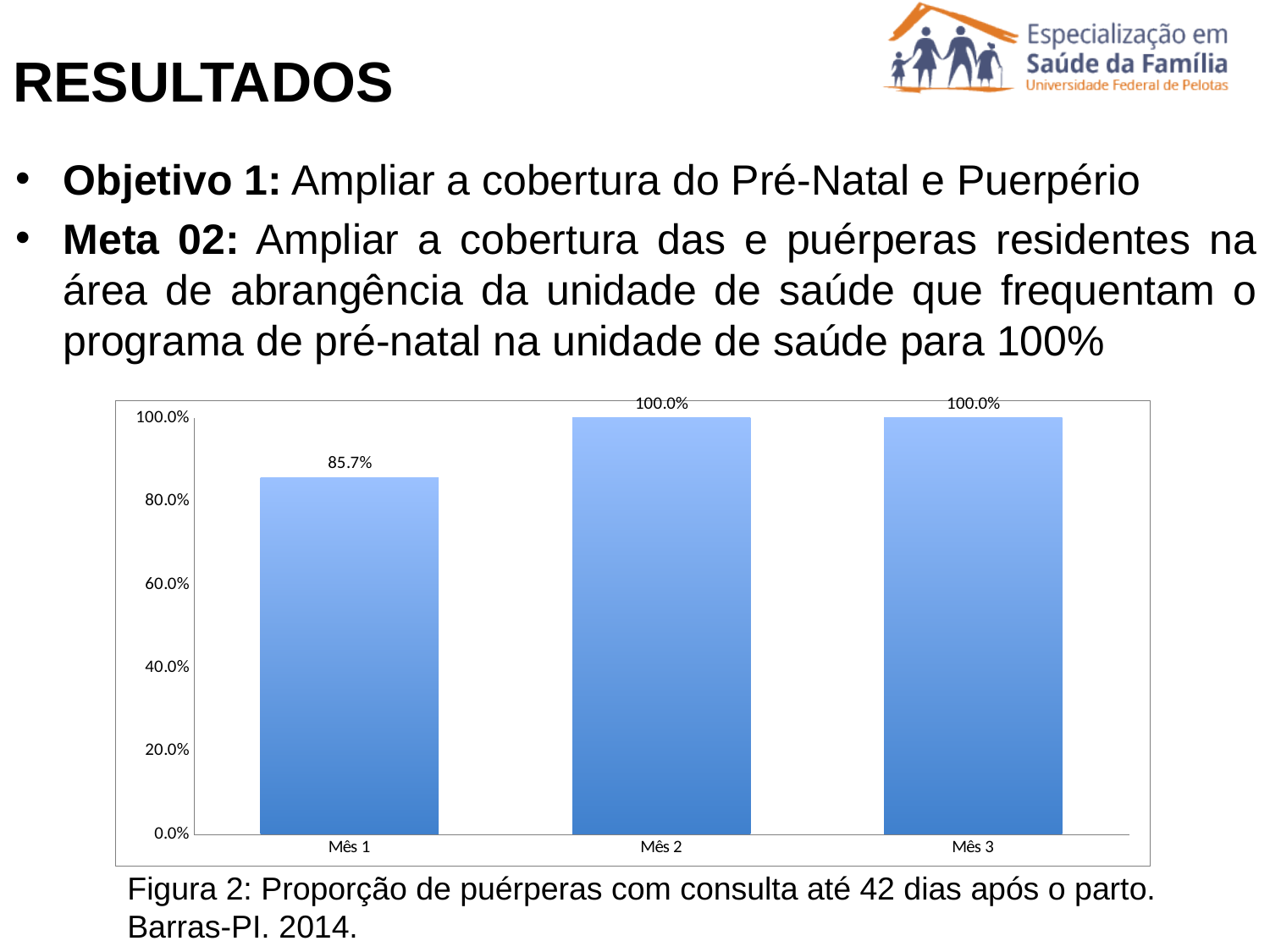
What is the difference between the values for Mês 2 and Mês 1? 14.3% What is the highest tick value shown on the y axis? 100.0% Is the value for Mês 1 greater or less than 80.0%? greater What kind of chart is shown on the slide? bar chart What is the value for Mês 3? 100.0% What is the caption of the figure below the chart? Figura 2: Proporção de puérperas com consulta até 42 dias após o parto. Barras-PI. 2014. Which is larger, the value for Mês 1 or the value for Mês 3? Mês 3 What is the value for Mês 2? 100.0% What is the value for Mês 1? 85.7% Do the values rise or fall from Mês 1 to Mês 2? rise Which month has the lowest value? Mês 1 How many months are shown on the x axis? 3